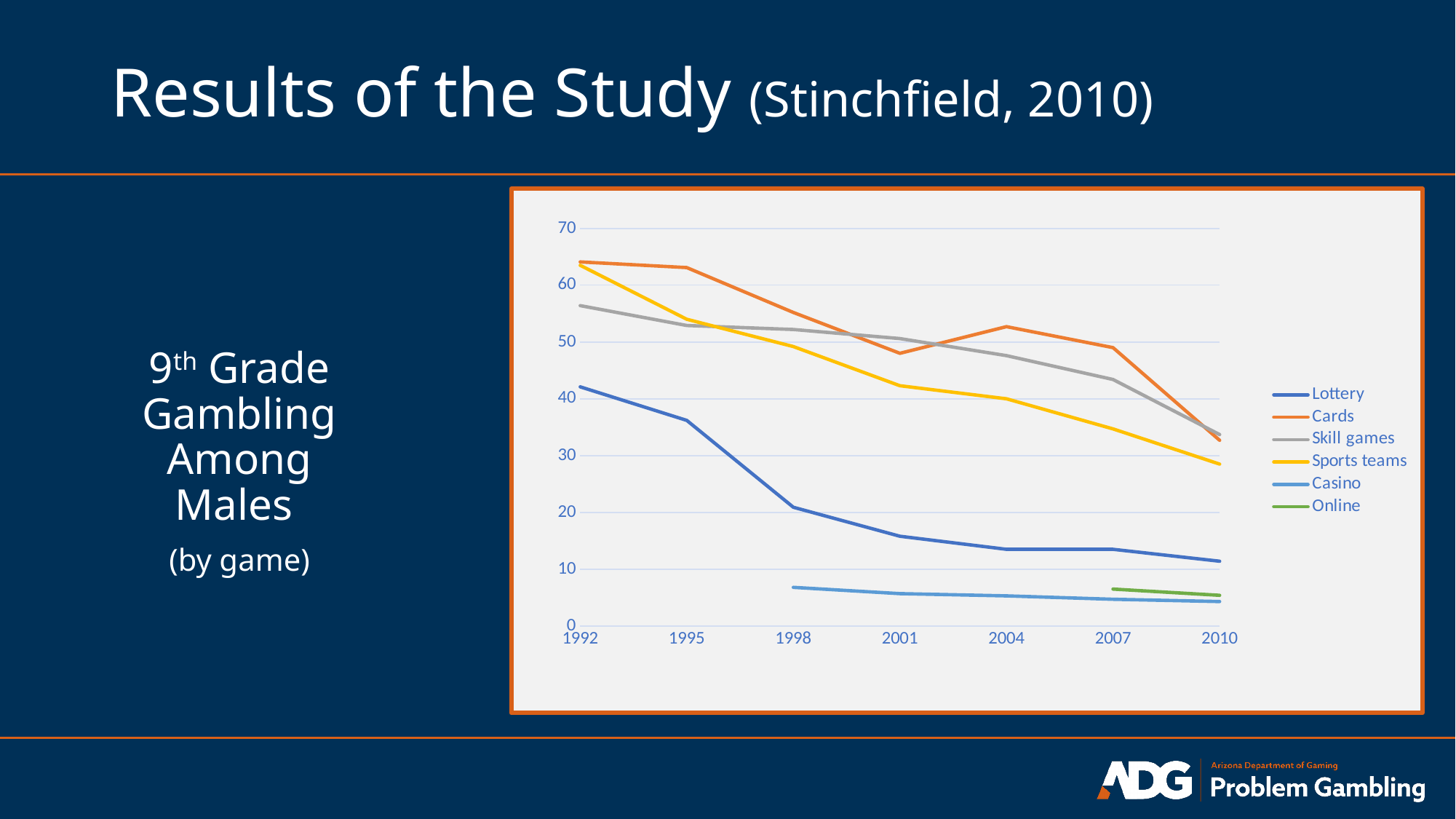
How many series does the legend list? 6 In 2004, which is larger, Cards or Sports teams? Cards Which series has the lowest value in 1992? Lottery Does the Lottery line rise or fall from 1992 to 2010? fall Which series has the highest value in 2007? Cards Is the value for Cards in 1992 greater or less than 60? greater Is the value for Sports teams in 2010 greater or less than 30? less What colour is the Cards line in the legend? orange Is the value for Casino in 1998 greater or less than 10? less What kind of chart is shown on the slide? line chart How many years are shown on the x axis? 7